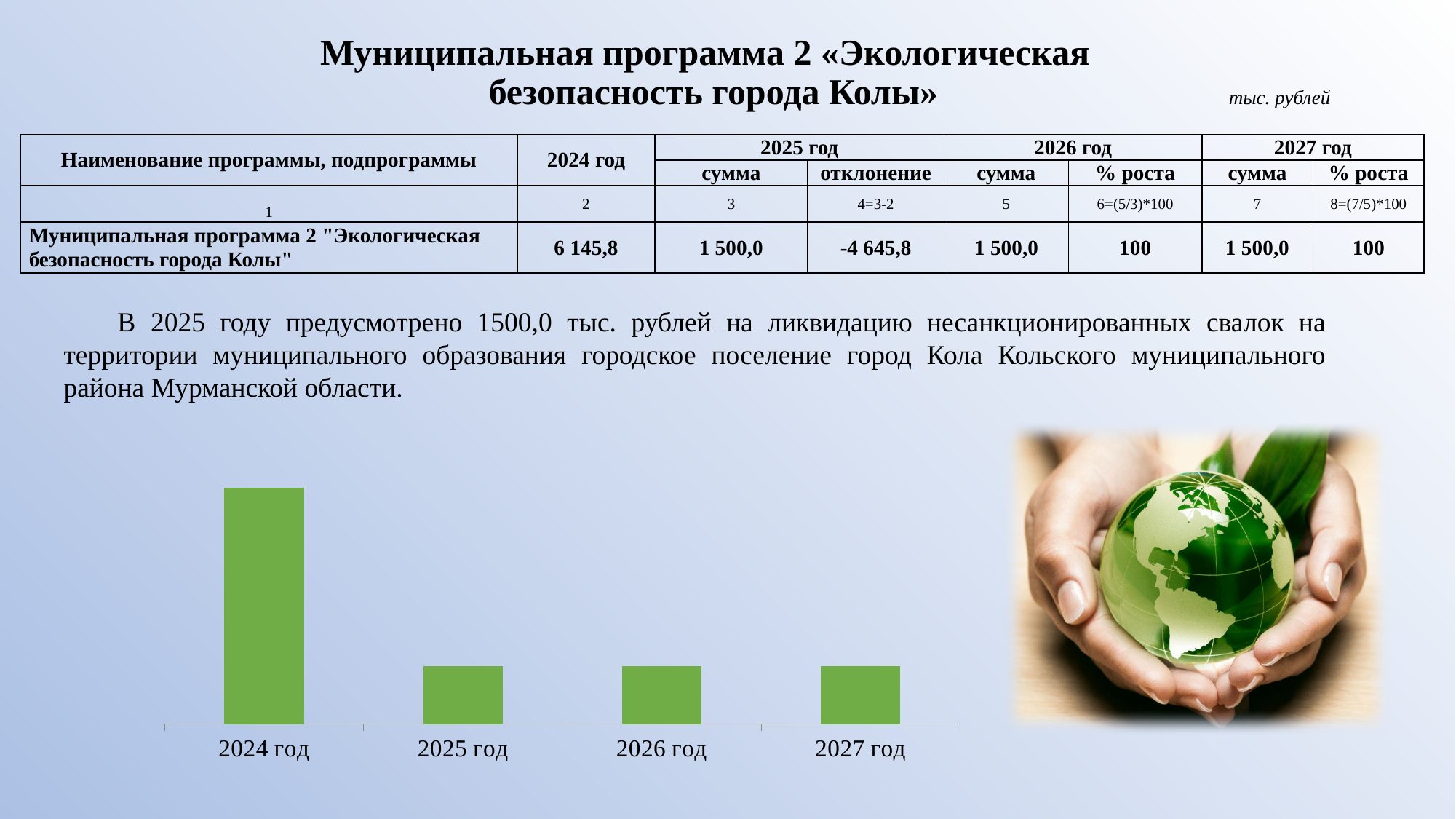
Which year has the highest bar in the chart? 2024 год How many bars (categories) does the chart show? 4 Which of the two bars is taller, 2024 год or 2027 год? 2024 год Which of the two bars is taller, 2024 год or 2025 год? 2024 год What is the label of the last category on the x axis of the chart? 2027 год What kind of chart is shown on the slide? bar chart Do the bar values rise or fall from 2024 год to 2025 год? fall What is the label of the first category on the x axis of the chart? 2024 год